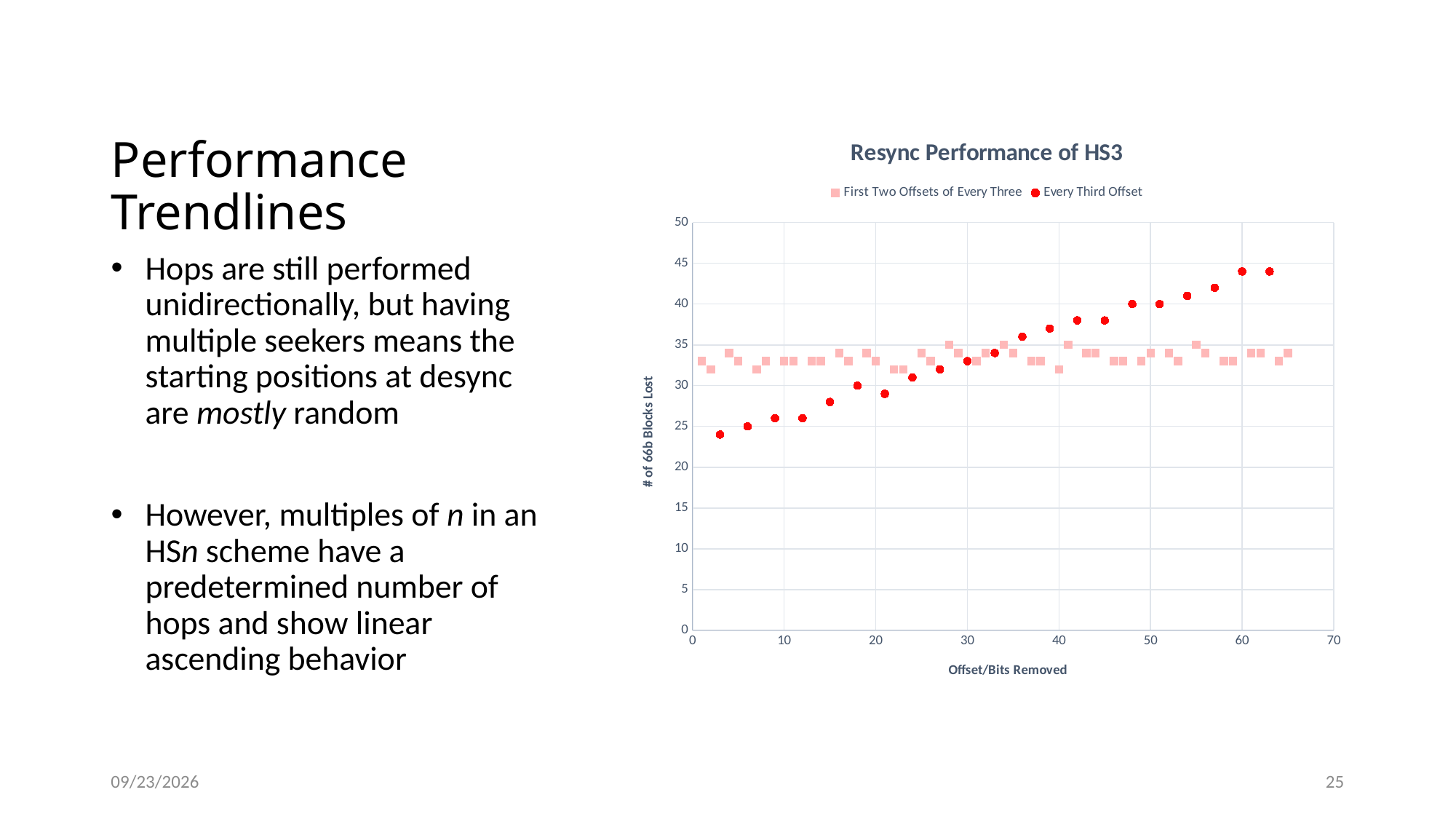
Are the values of the First Two Offsets of Every Three series greater or less than 40? less Is the value of the Every Third Offset series at offset 3 greater or less than 30? less Do the values of the Every Third Offset series rise or fall as Offset/Bits Removed increases? rise Are the values of the First Two Offsets of Every Three series greater or less than 30? greater What is the title of the chart? Resync Performance of HS3 At offset 3, which series has the higher value, Every Third Offset or First Two Offsets of Every Three? First Two Offsets of Every Three Which series is plotted with red circles? Every Third Offset At offset 60, which series has the higher value, Every Third Offset or First Two Offsets of Every Three? Every Third Offset How many series does the chart legend list? 2 What kind of chart is shown on the slide? scatter chart